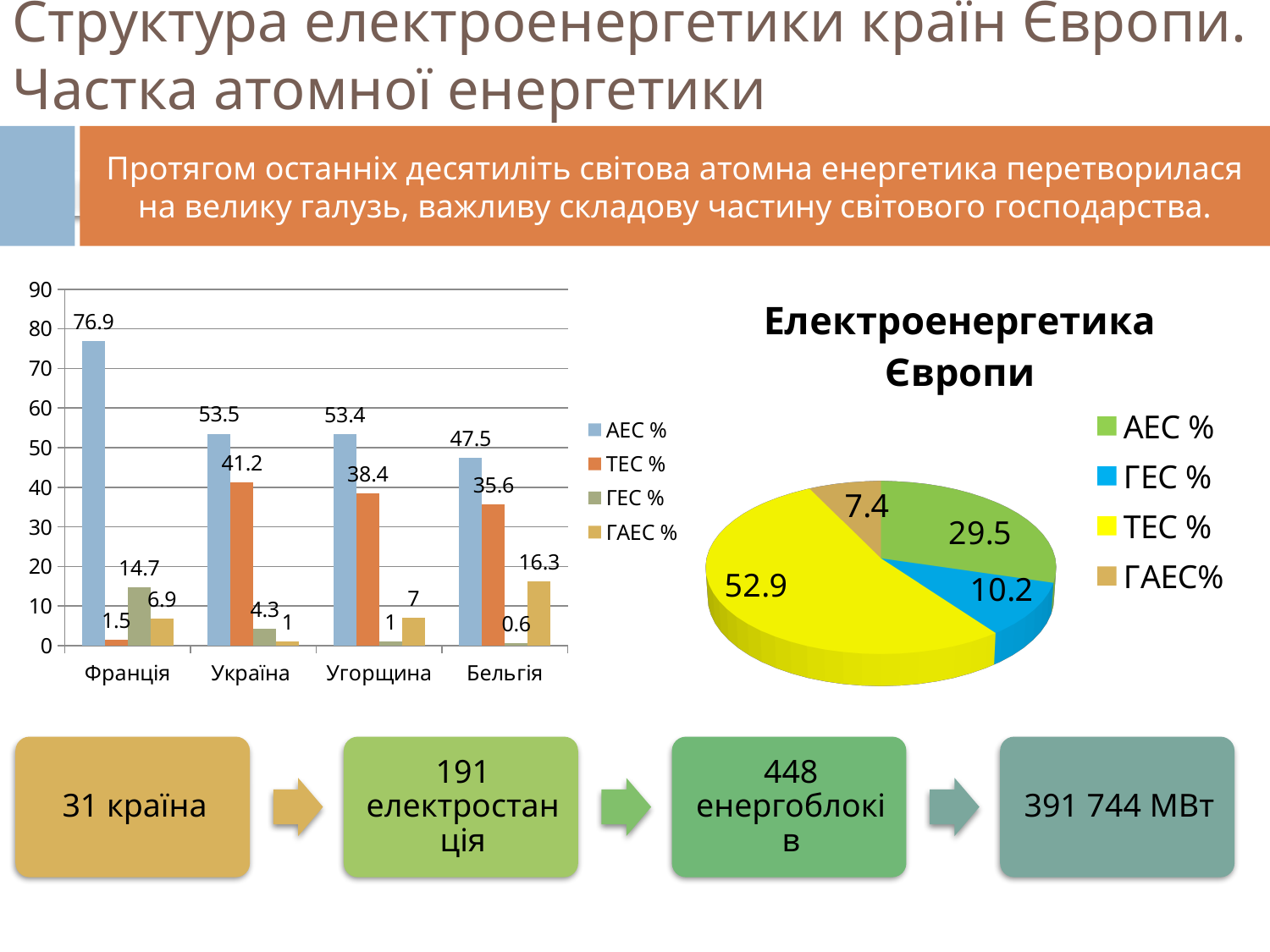
In the bar chart on the left, what is the ТЕС % value for Україна? 41.2 How many series does the legend of the bar chart on the left list? 4 In the pie chart titled 'Електроенергетика Європи', what is the value for ТЕС %? 52.9 In the bar chart on the left, which is larger: the ТЕС % value for Угорщина or for Бельгія? Угорщина In the bar chart on the left, which country has the lowest ГЕС % value? Бельгія In the bar chart on the left, what is the difference between the АЕС % values for Франція and Бельгія? 29.4 How many countries are shown on the x axis of the bar chart on the left? 4 What kind of chart is the chart titled 'Електроенергетика Європи'? pie chart In the bar chart on the left, which country has the highest АЕС % value? Франція In the pie chart titled 'Електроенергетика Європи', which category has the smallest slice? ГАЕС% In the bar chart on the left, what is the АЕС % value for Франція? 76.9 In the bar chart on the left, what is the ГАЕС % value for Бельгія? 16.3